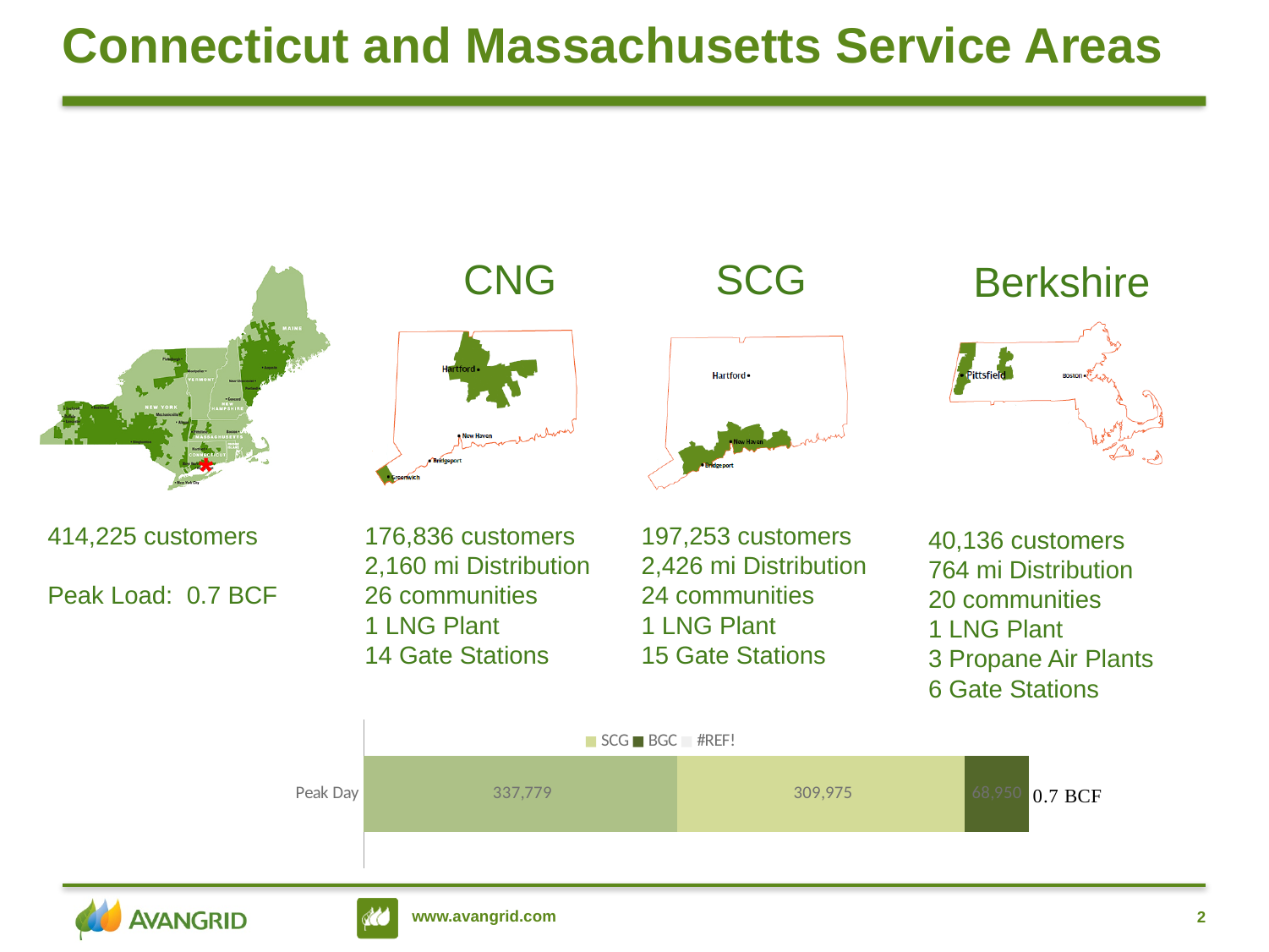
What is the label of the single category on the bar chart? Peak Day How many categories are plotted on the bar chart's axis? 1 What is the difference between the leftmost segment (337,779) and the middle segment (309,975) of the Peak Day bar? 27,804 What kind of chart is shown at the bottom of the slide? Stacked bar chart What is the value of the leftmost segment of the Peak Day bar? 337,779 Which segment of the Peak Day bar has the largest value? The leftmost segment, 337,779 Which segment of the Peak Day bar has the smallest value? The rightmost segment, 68,950 What is the total of all three segments of the Peak Day stacked bar? 716,704 What are the entries in the bar chart's legend? SCG, BGC, #REF! How many series does the bar chart's legend list? 3 What is the value of the middle segment of the Peak Day bar? 309,975 What is the value of the rightmost (dark green) segment of the Peak Day bar? 68,950